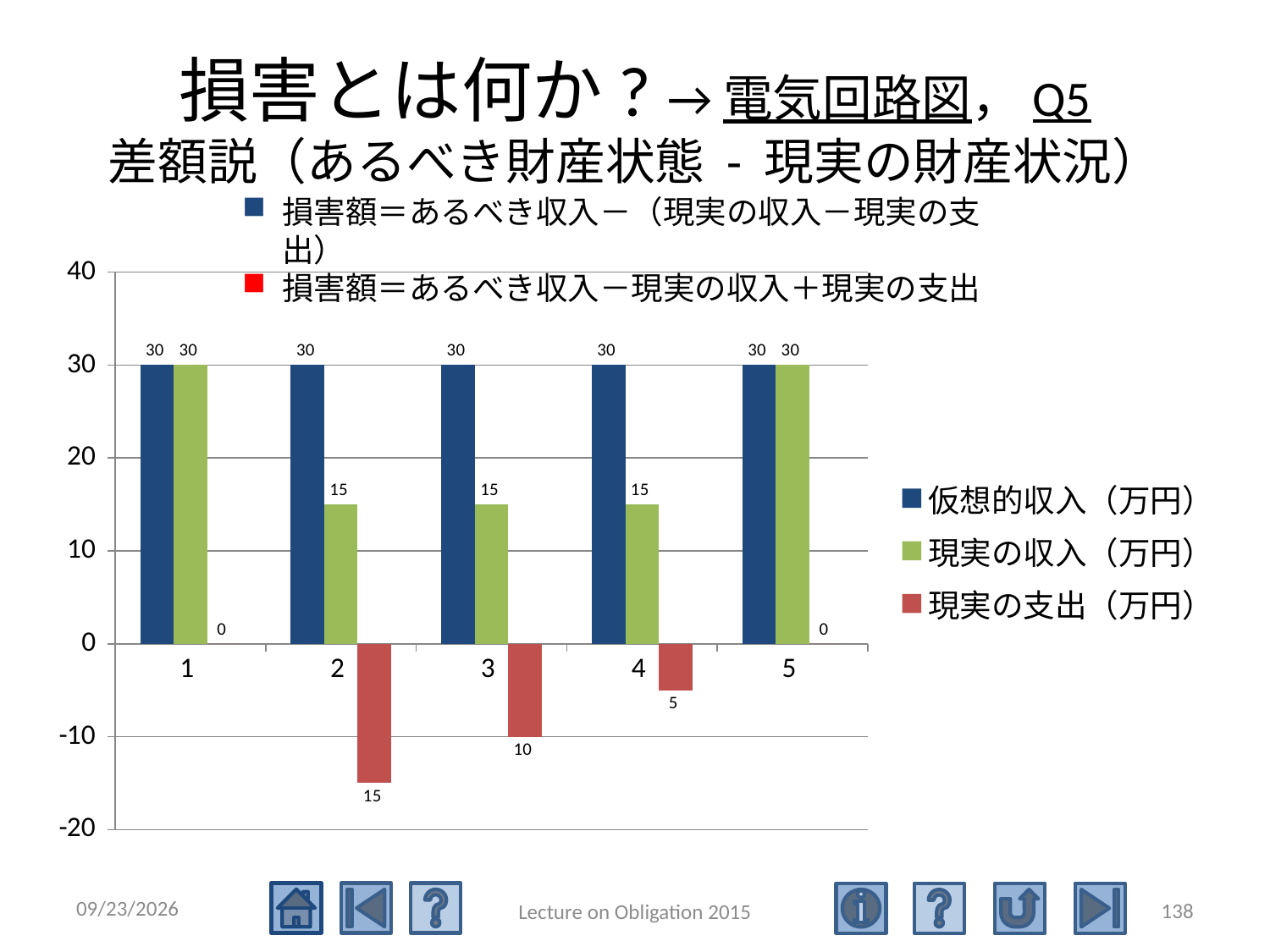
What is the difference between 仮想的収入（万円） and 現実の収入（万円） for category 4? 15 Is the 現実の収入（万円） value for category 3 greater or less than 20? less What is the data label on the 現実の支出（万円） bar for category 1? 0 What is the data label on the 現実の支出（万円） bar for category 3? 10 How many categories are shown on the x axis? 5 Which legend entry is shown in green? 現実の収入（万円） Which category has the largest 現実の支出（万円） bar (furthest below zero)? 2 How many series does the legend list? 3 What kind of chart is shown on the slide? bar chart For category 5, is 仮想的収入（万円） larger than, smaller than, or equal to 現実の収入（万円）? equal What is the value of 仮想的収入（万円） for category 3? 30 What is the value of 現実の収入（万円） for category 2? 15